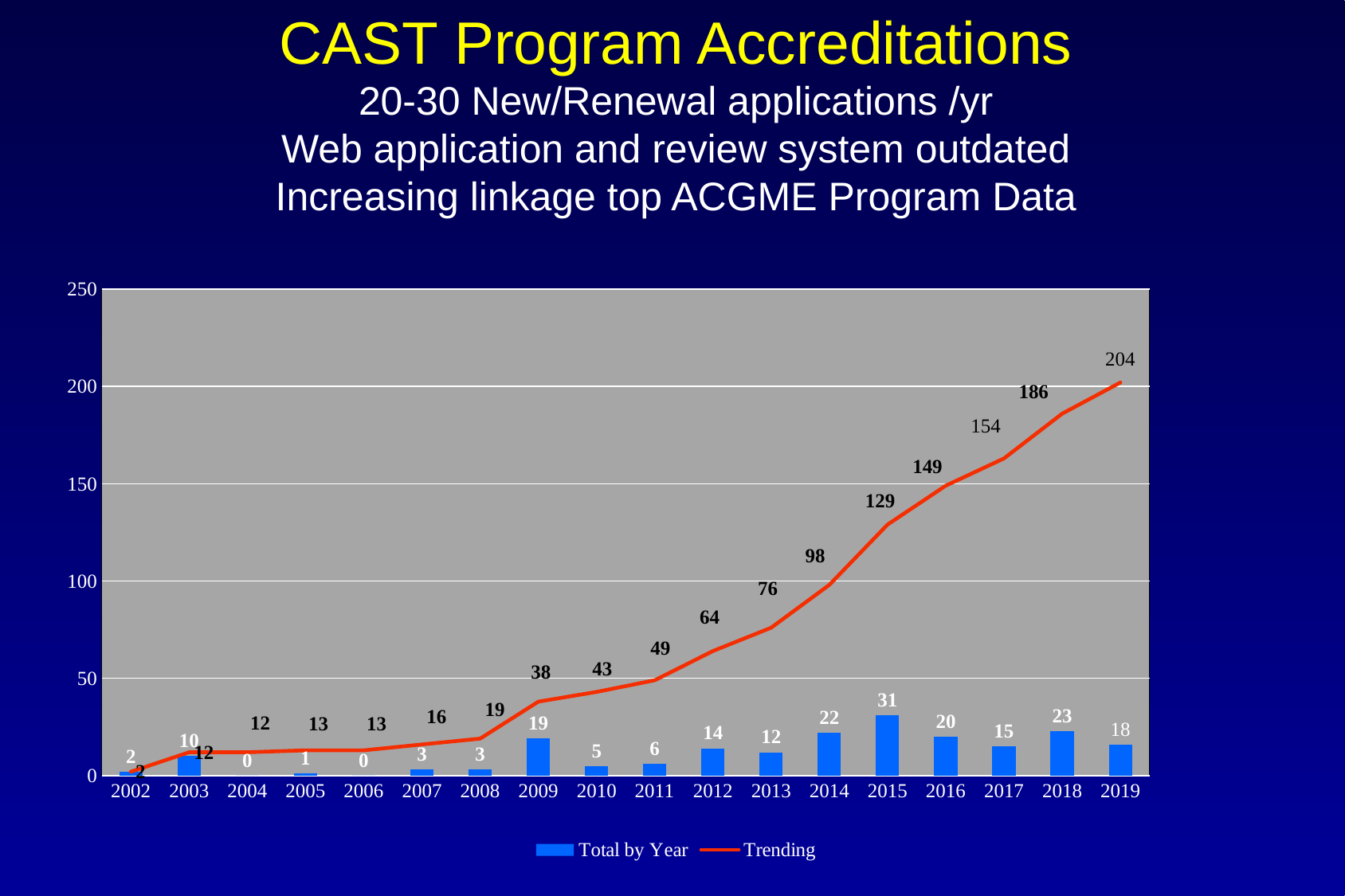
How many years are shown on the x axis? 18 How many series does the legend list? 2 What is the Total by Year value for 2015? 31 Which year has the highest Total by Year value? 2015 What is the Total by Year value for 2009? 19 Is the Trending value for 2016 greater or less than 100? greater Does the Trending line rise or fall from 2002 to 2019? rises What is the Trending value for 2019? 204 What is the difference between the Trending values for 2018 and 2017? 32 Which is larger, the Total by Year value for 2014 or for 2016? 2014 What colour is the Trending line? Red What is the Trending value for 2014? 98